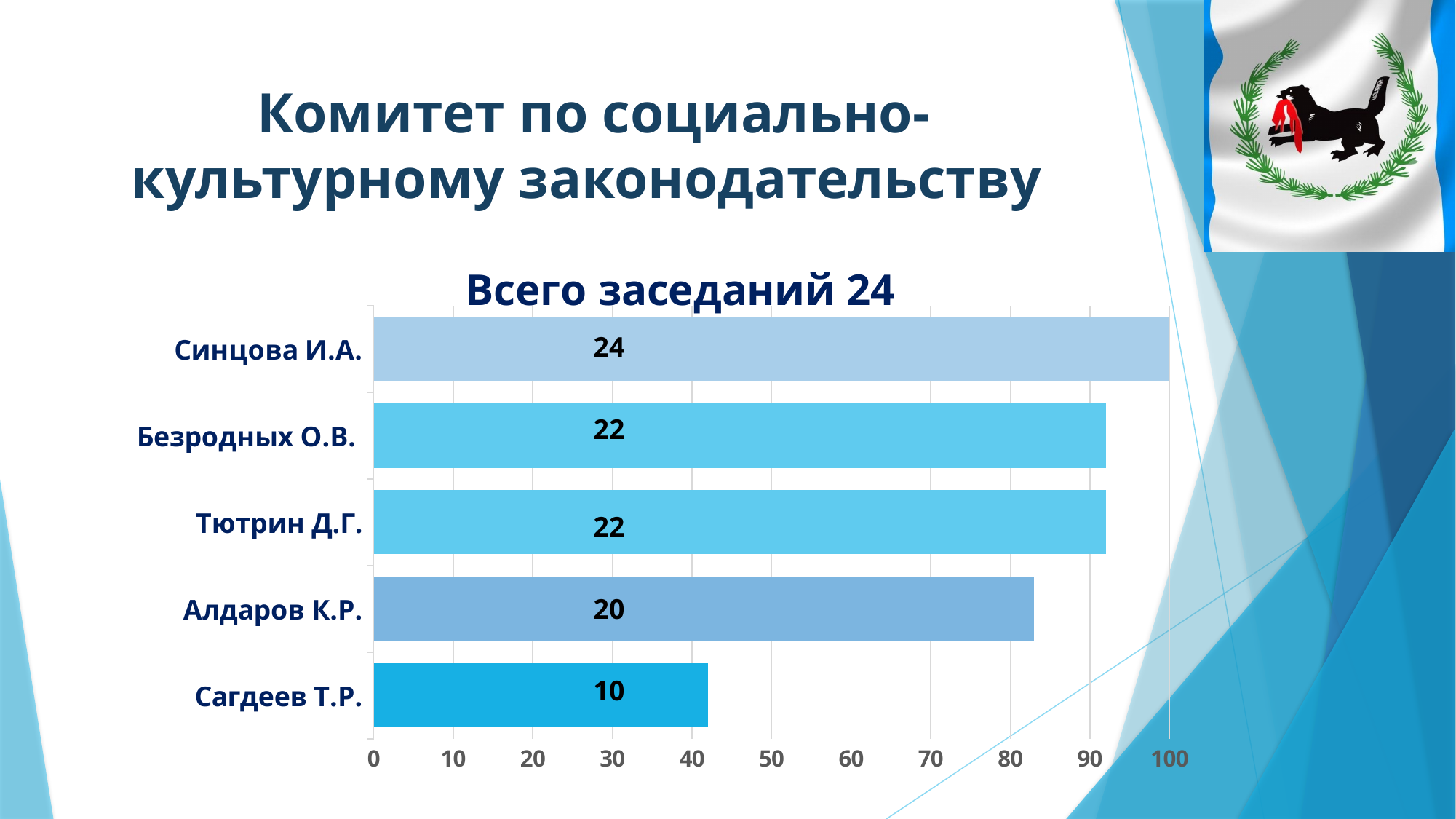
Which person has the lowest value in the chart? Сагдеев Т.Р. What is the difference between the values for Тютрин Д.Г. and Алдаров К.Р.? 2 How many people are listed in the chart? 5 What value is shown for Безродных О.В.? 22 What is the title of the chart? Всего заседаний 24 What kind of chart is shown on the slide? Bar chart What value is shown for Алдаров К.Р.? 20 Which is larger, the value for Алдаров К.Р. or the value for Сагдеев Т.Р.? Алдаров К.Р. What is the difference between the values for Синцова И.А. and Сагдеев Т.Р.? 14 What value is shown for Синцова И.А.? 24 Which person has the highest value in the chart? Синцова И.А. What value is shown for Сагдеев Т.Р.? 10